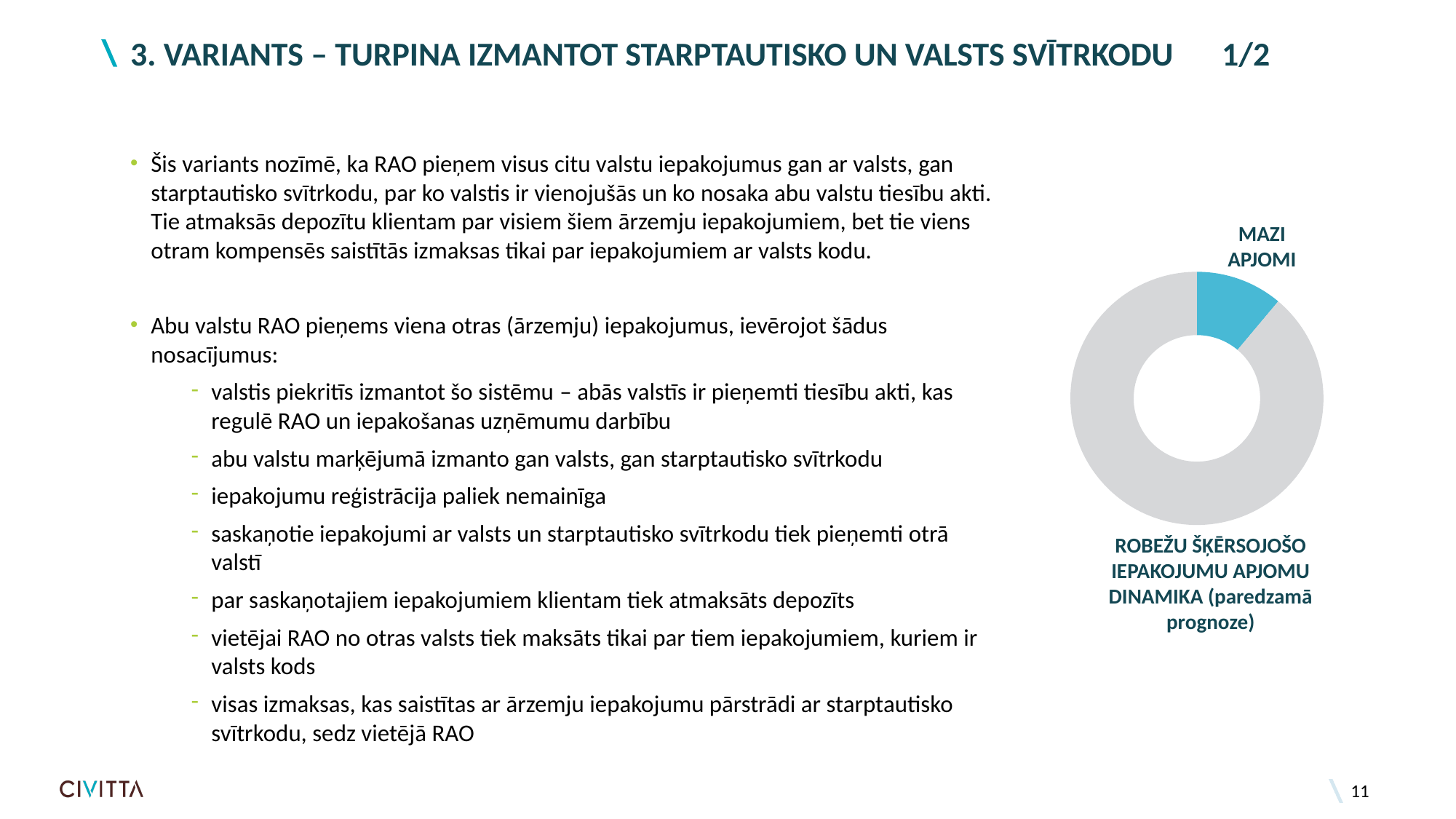
In the donut chart, is the blue slice the largest or the smallest slice? The smallest What kind of chart is shown on the right side of the slide? Donut (pie) chart What label is attached to the blue slice of the donut chart? MAZI APJOMI What is the title written below the donut chart? ROBEŽU ŠĶĒRSOJOŠO IEPAKOJUMU APJOMU DINAMIKA (paredzamā prognoze) In the donut chart, which slice is larger: the blue slice or the grey slice? The grey slice How many slices does the donut chart on the slide have? 2